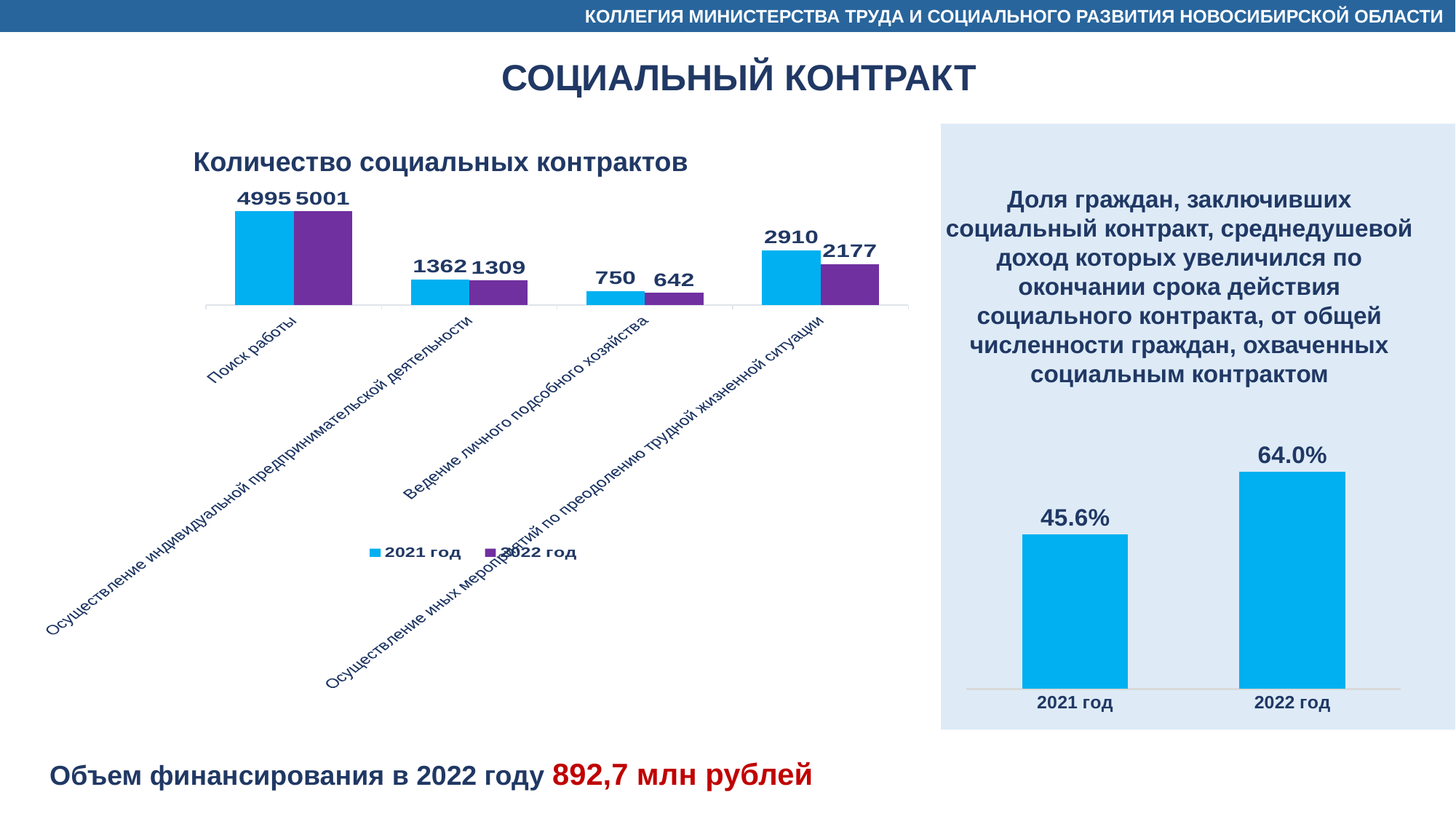
In the chart 'Количество социальных контрактов', what is the value for 'Ведение личного подсобного хозяйства' in 2022 год? 642 In the chart on the right side of the slide, what is the value for 2021 год? 45.6% In the chart 'Количество социальных контрактов', which category has the highest value in 2021 год? Поиск работы What type of chart is the chart on the right side of the slide showing 45.6% and 64.0%? Bar chart In the chart 'Количество социальных контрактов', what is the value for 'Поиск работы' in 2021 год? 4995 How many series does the legend of the chart 'Количество социальных контрактов' list? 2 In the chart on the right side of the slide, what is the difference between the 2022 год and 2021 год values? 18.4% In the chart 'Количество социальных контрактов', what is the 2022 год value for 'Осуществление индивидуальной предпринимательской деятельности'? 1309 In the chart 'Количество социальных контрактов', which category has the lowest value in 2022 год? Ведение личного подсобного хозяйства In the chart 'Количество социальных контрактов', which is larger for 'Поиск работы': the 2021 год value or the 2022 год value? 2022 год How many categories are shown in the chart 'Количество социальных контрактов'? 4 In the chart 'Количество социальных контрактов', what is the difference between the 2021 год and 2022 год values for 'Осуществление иных мероприятий по преодолению трудной жизненной ситуации'? 733